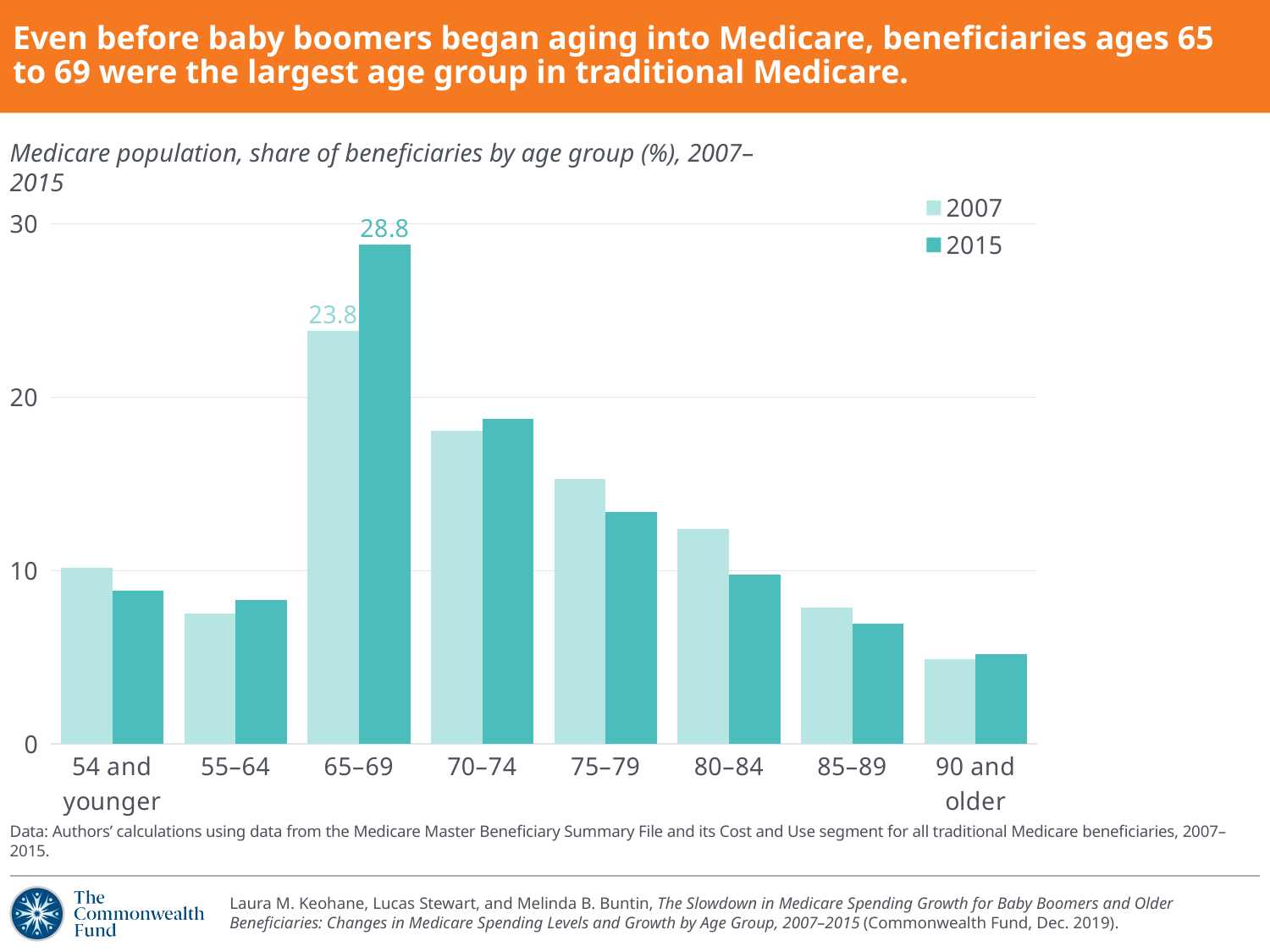
How many series does the legend list? 2 Is the 2015 value for the 85–89 age group greater or less than 10? less What is the 2007 value for the 65–69 age group? 23.8 By how much did the share for the 65–69 age group increase from 2007 to 2015? 5.0 What is the 2015 value for the 65–69 age group? 28.8 For the 54 and younger group, which year has the larger share, 2007 or 2015? 2007 How many age groups are shown on the x axis? 8 Which age group has the lowest share in 2007? 90 and older Is the 2007 value for the 75–79 age group greater or less than 10? greater For the 55–64 group, which year has the larger share, 2007 or 2015? 2015 What kind of chart is shown on the slide? Bar chart Which age group has the highest share in 2015? 65–69